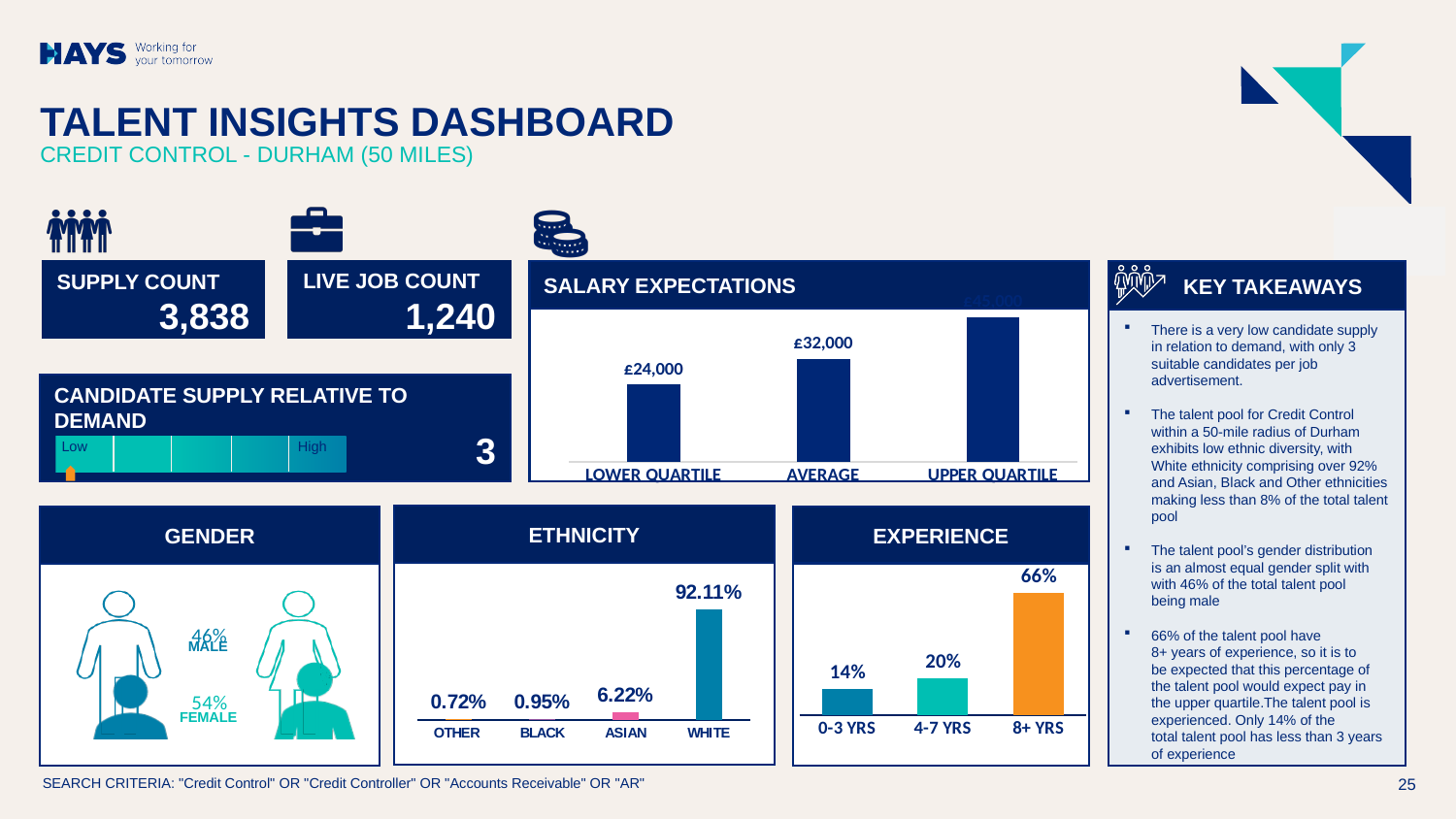
In the Experience chart, which experience band has the highest value? 8+ YRS In the Ethnicity chart, what percentage is shown for Asian? 6.22% In the Salary Expectations chart, which category has the tallest bar? Upper Quartile In the Salary Expectations chart, what is the difference between the Average and the Lower Quartile values? £8,000 In the Ethnicity chart, which category has the lowest value? Other In the Experience chart, what is the difference between the 8+ YRS value and the 0-3 YRS value? 52% In the Experience chart, what percentage of the talent pool has 4-7 years of experience? 20% In the Ethnicity chart, what percentage is shown for White? 92.11% In the Salary Expectations chart, what is the Average salary value? £32,000 In the Salary Expectations chart, what is the salary value for the Lower Quartile? £24,000 What type of chart is used in the Experience panel? Bar chart In the Ethnicity chart, how many categories are plotted? 4